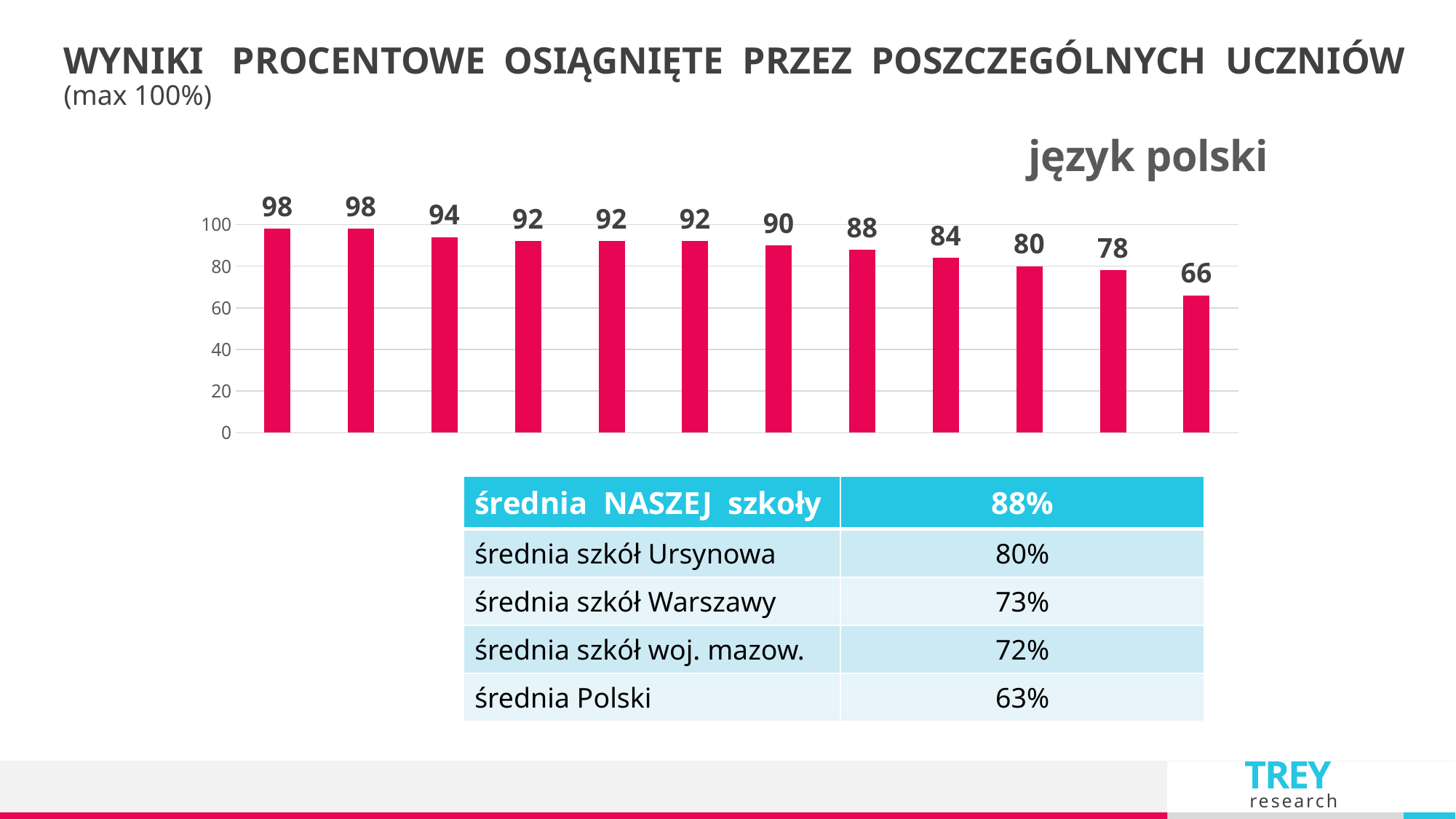
Do the bar values rise or fall from left to right across the chart? fall What type of chart is shown on the slide? bar chart What is the value of the seventh bar from the left? 90 What is the highest value shown in the chart? 98 What subject title is shown above the chart? język polski What is the value of the last bar on the right? 66 How many bars are plotted in the chart? 12 Which is larger: the value of the ninth bar from the left or the value of the tenth bar from the left? the ninth bar (84) Is the value of the last bar greater or less than 60? greater What is the value of the third bar from the left? 94 What is the lowest value shown in the chart? 66 What is the difference between the first bar (98) and the last bar (66)? 32